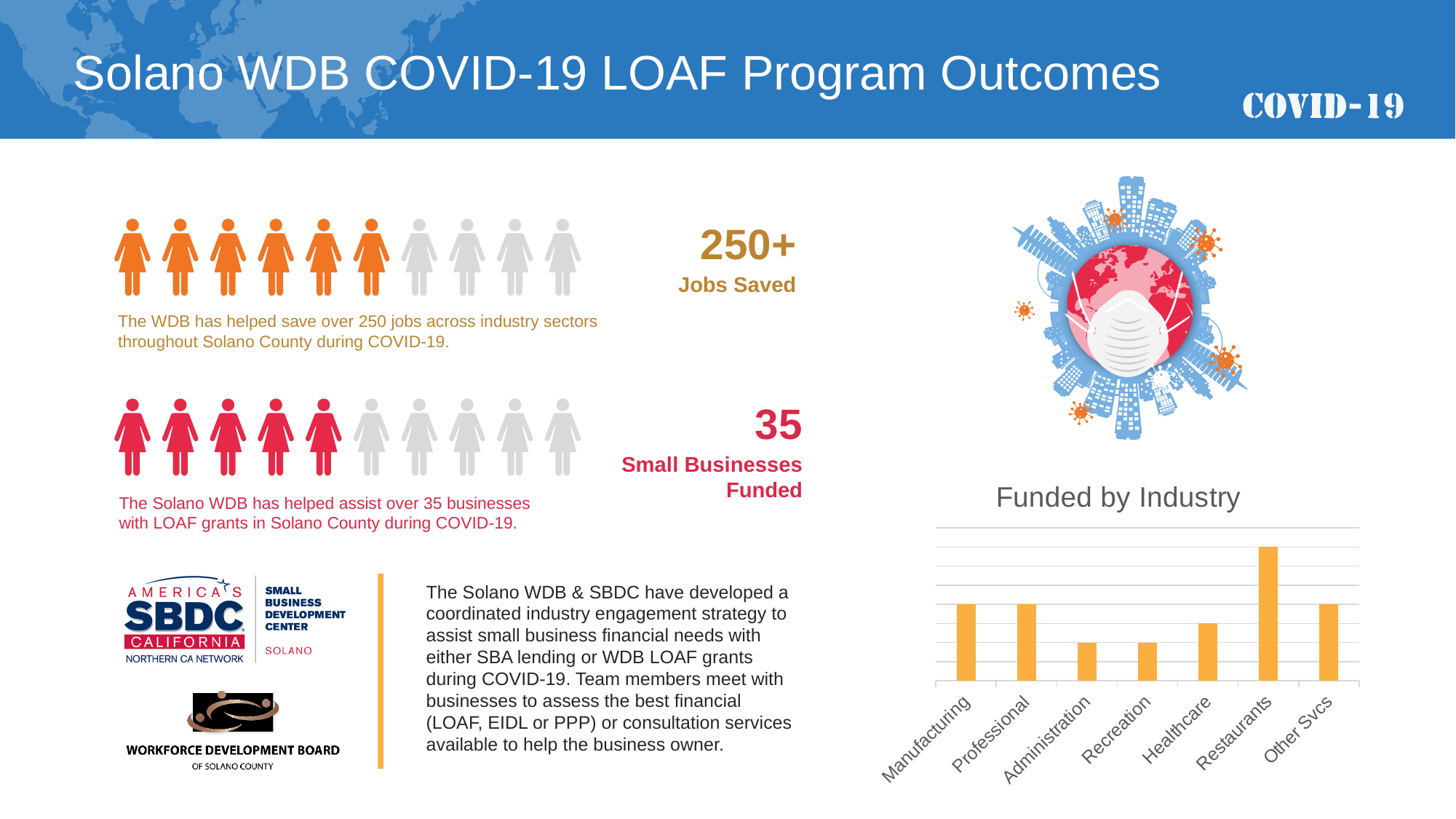
In the "Funded by Industry" chart, which category is listed first on the x axis? Manufacturing What kind of chart is the "Funded by Industry" chart? bar chart In the "Funded by Industry" chart, which is larger, the value for Manufacturing or the value for Administration? Manufacturing In the "Funded by Industry" chart, which is larger, the value for Healthcare or the value for Recreation? Healthcare In the "Funded by Industry" chart, which industry has the highest bar? Restaurants In the "Funded by Industry" chart, which is larger, the value for Restaurants or the value for Healthcare? Restaurants What colour are the bars in the "Funded by Industry" chart? orange How many industry categories are shown in the "Funded by Industry" chart? 7 What is the title of the chart on the slide? Funded by Industry